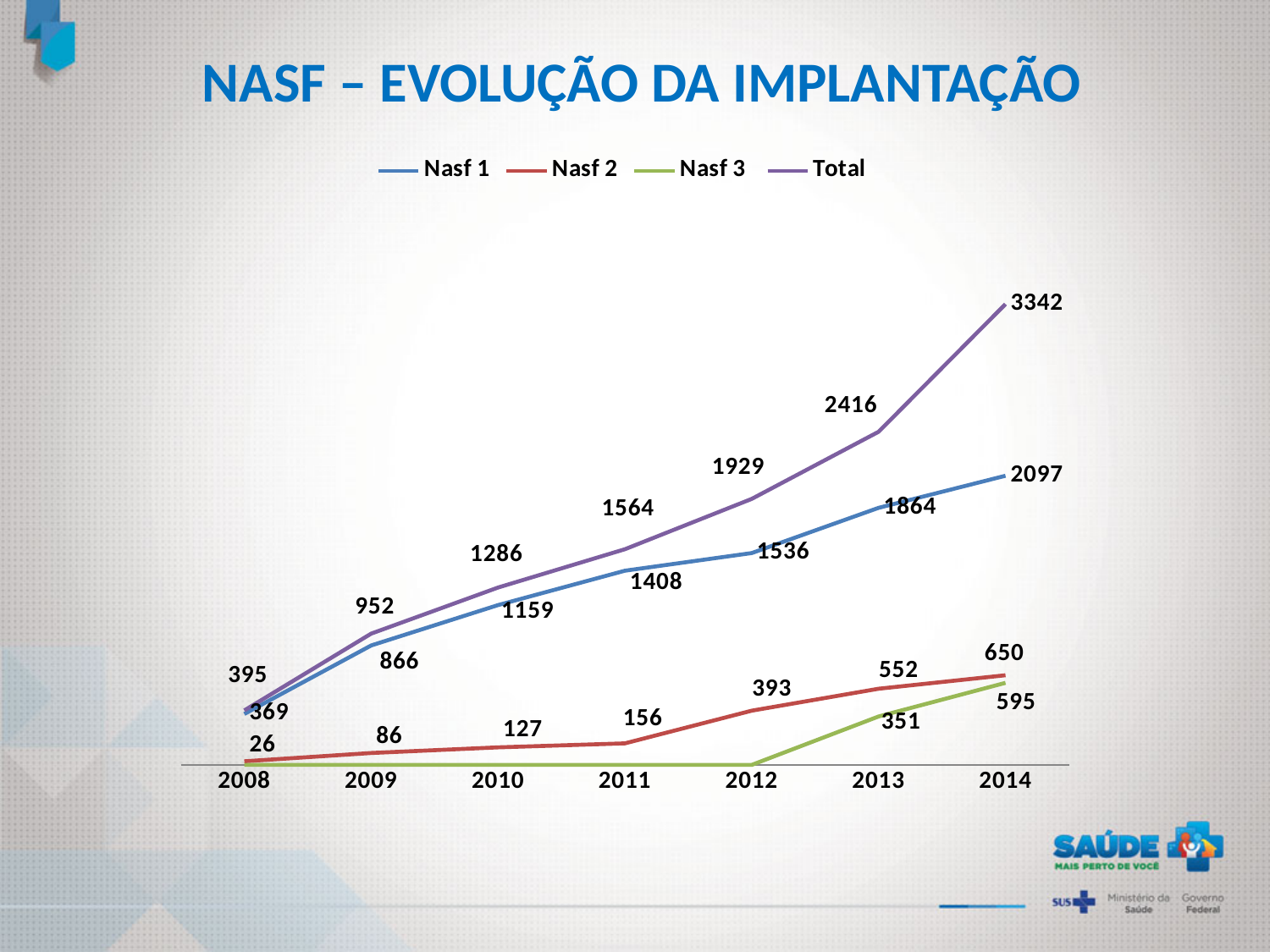
What is the title of the chart? NASF – EVOLUÇÃO DA IMPLANTAÇÃO What is the difference between the Total values for 2014 and 2013? 926 What is the value of Nasf 1 in 2011? 1408 How many years are shown on the x axis? 7 Does the Total series rise or fall from 2008 to 2014? rise How many series does the legend list? 4 What is the value of Nasf 3 in 2013? 351 What kind of chart is shown on the slide? line chart What is the value of Total in 2014? 3342 In 2014, which is larger: Nasf 2 or Nasf 3? Nasf 2 What is the value of Nasf 2 in 2012? 393 In which year is the Total series highest? 2014